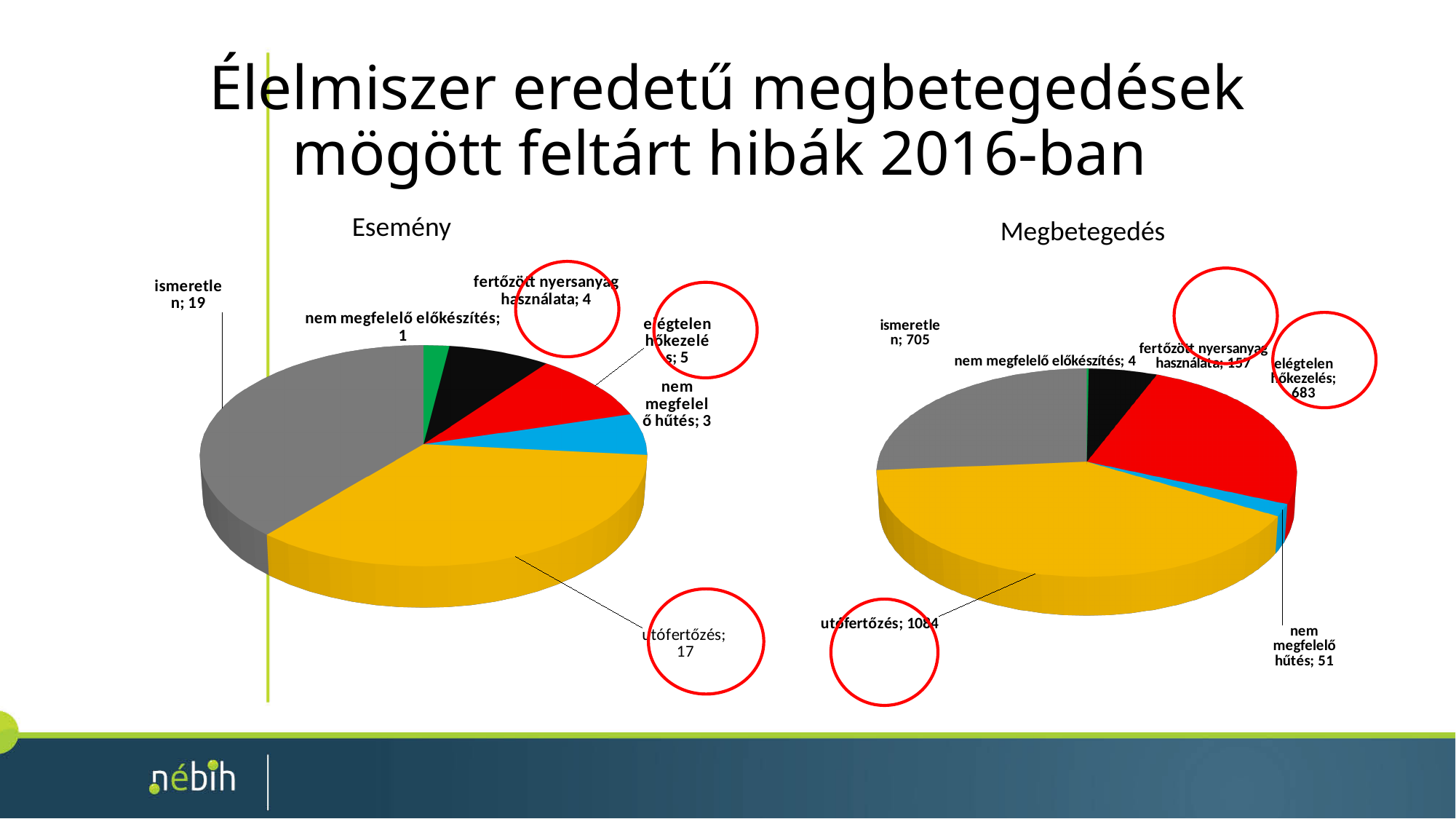
On the Megbetegedés chart, which category has the lowest value? nem megfelelő előkészítés On the Megbetegedés chart, what is the difference between utófertőzés and ismeretlen? 379 What kind of chart is the Esemény chart? pie chart On the Esemény chart, which category has the lowest value? nem megfelelő előkészítés On the Megbetegedés chart, what is the value for elégtelen hőkezelés? 683 On the Esemény chart, which is larger: elégtelen hőkezelés or fertőzött nyersanyag használata? elégtelen hőkezelés On the Esemény chart, what is the value for ismeretlen? 19 On the Esemény chart, what is the value for utófertőzés? 17 On the Megbetegedés chart, which category has the highest value? utófertőzés On the Esemény chart, what is the difference between ismeretlen and utófertőzés? 2 How many slices does the Megbetegedés chart have? 6 On the Megbetegedés chart, what is the value for nem megfelelő hűtés? 51